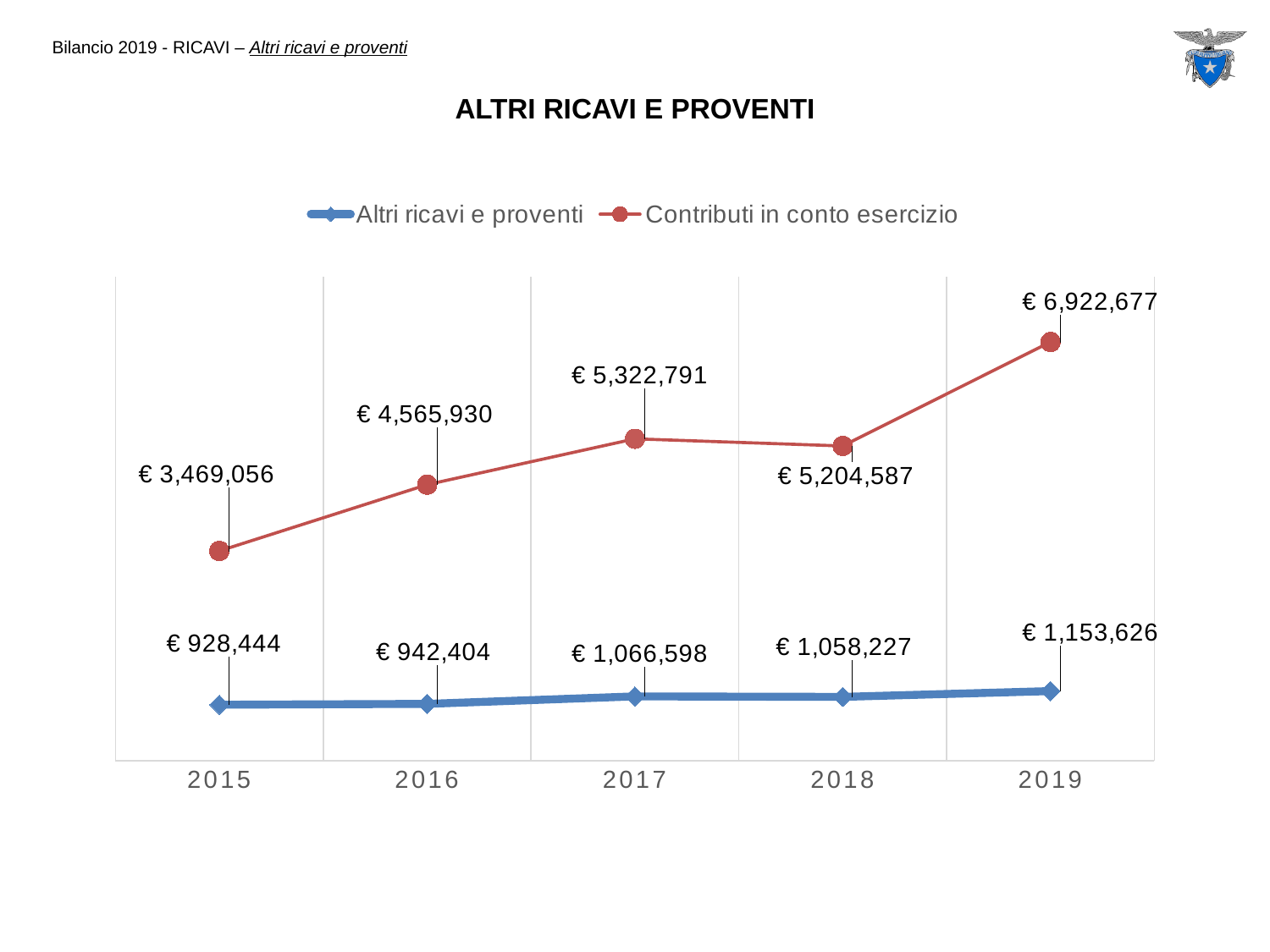
How many series does the legend list? 2 What is the value of Contributi in conto esercizio in 2019? € 6,922,677 What type of chart is shown on the slide? Line chart What is the title of the chart? ALTRI RICAVI E PROVENTI What is the difference between Altri ricavi e proventi in 2019 and in 2015? € 225,182 Which is larger for Contributi in conto esercizio: the 2017 value or the 2018 value? 2017 What is the difference between Contributi in conto esercizio in 2019 and in 2018? € 1,718,090 How many years are plotted on the x axis? 5 What is the value of Contributi in conto esercizio in 2016? € 4,565,930 In which year is Contributi in conto esercizio highest? 2019 What is the value of Altri ricavi e proventi in 2015? € 928,444 In which year is Altri ricavi e proventi lowest? 2015